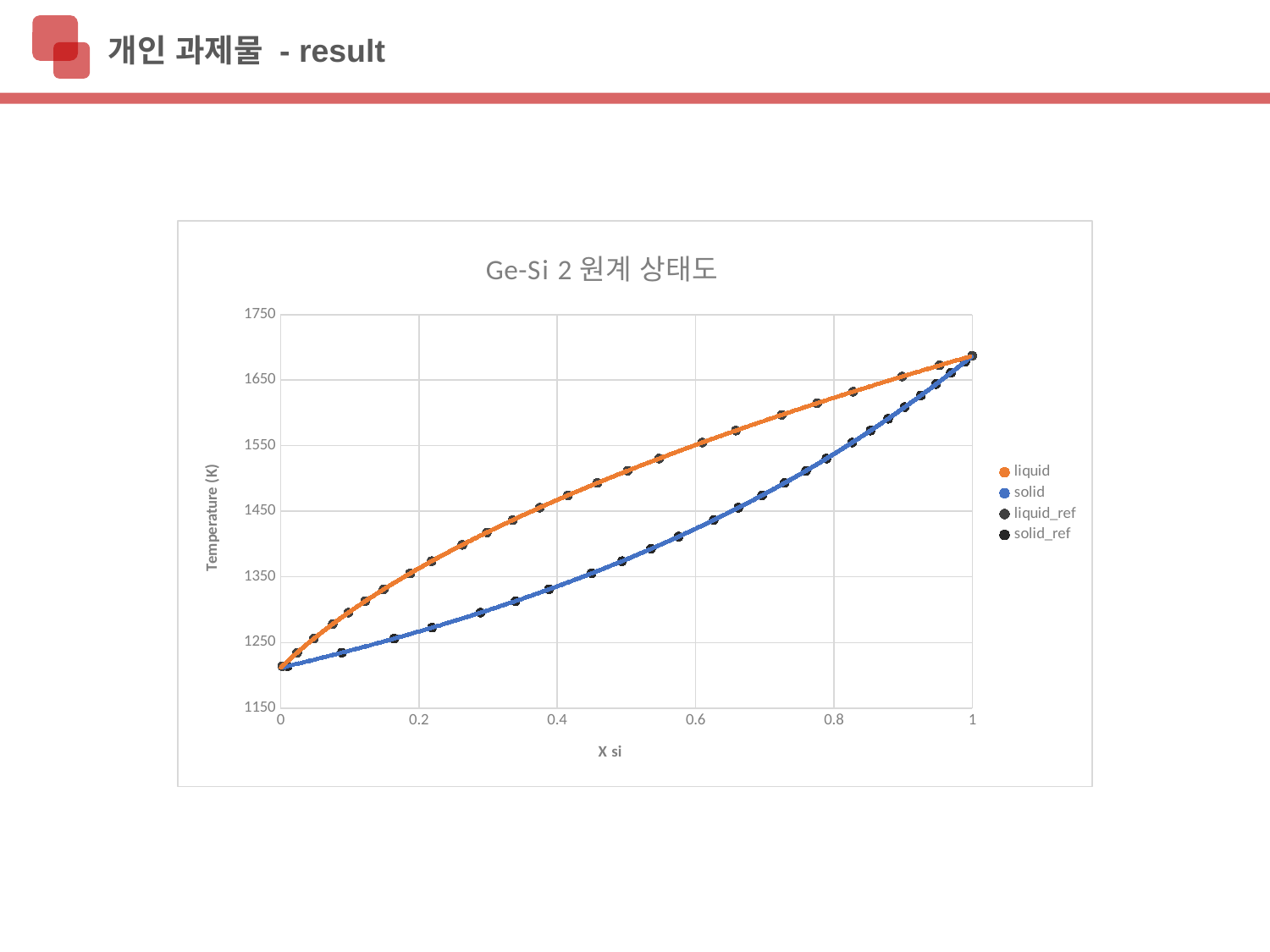
Is the temperature of the liquid series at X si = 0.4 greater or less than 1450? greater Does the liquid series rise or fall as X si increases from 0 to 1? rise At X si = 0.4, which series has the higher temperature, liquid or solid? liquid What kind of chart is shown on the slide? line chart Is the temperature of the solid series at X si = 0.6 greater or less than 1450? less Is the temperature of the solid series at X si = 0.4 greater or less than 1350? less What is the label of the y axis? Temperature (K) What is the title of the chart? Ge-Si 2 원계 상태도 Does the solid series rise or fall as X si increases from 0 to 1? rise How many series does the legend list? 4